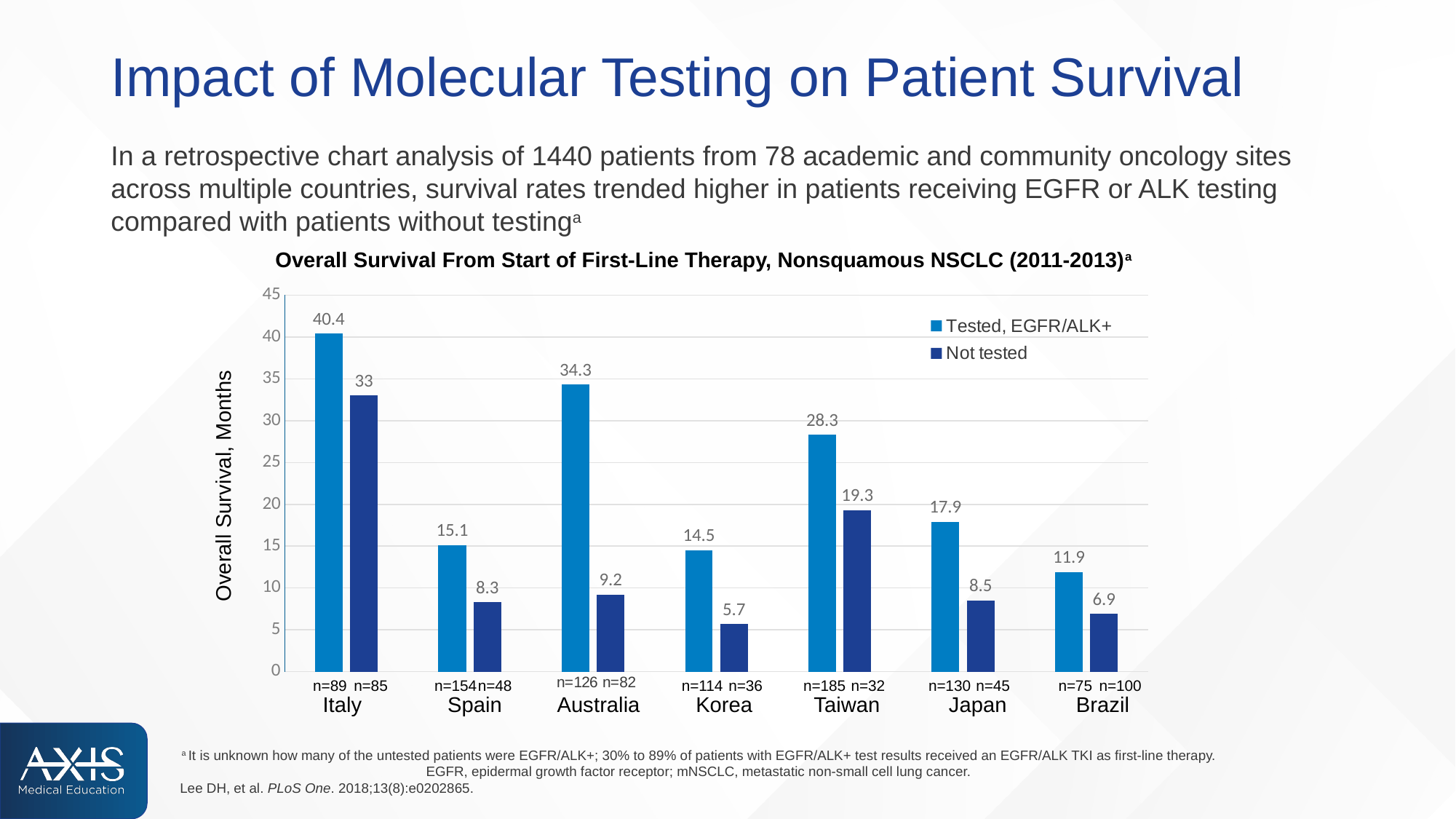
How many countries are shown on the x axis? 7 What is the label of the y axis? Overall Survival, Months How many series does the legend list? 2 What is the overall survival in months for tested, EGFR/ALK+ patients in Italy? 40.4 What is the overall survival in months for not tested patients in Korea? 5.7 What kind of chart is shown on the slide? bar chart Is the tested, EGFR/ALK+ value for Brazil greater or less than 15? less Which country has the highest overall survival for tested, EGFR/ALK+ patients? Italy What is the difference in overall survival months between tested and not tested patients in Australia? 25.1 What is the overall survival in months for tested, EGFR/ALK+ patients in Taiwan? 28.3 Which is larger: the not tested value for Japan or the not tested value for Spain? Japan Which country has the lowest overall survival for not tested patients? Korea